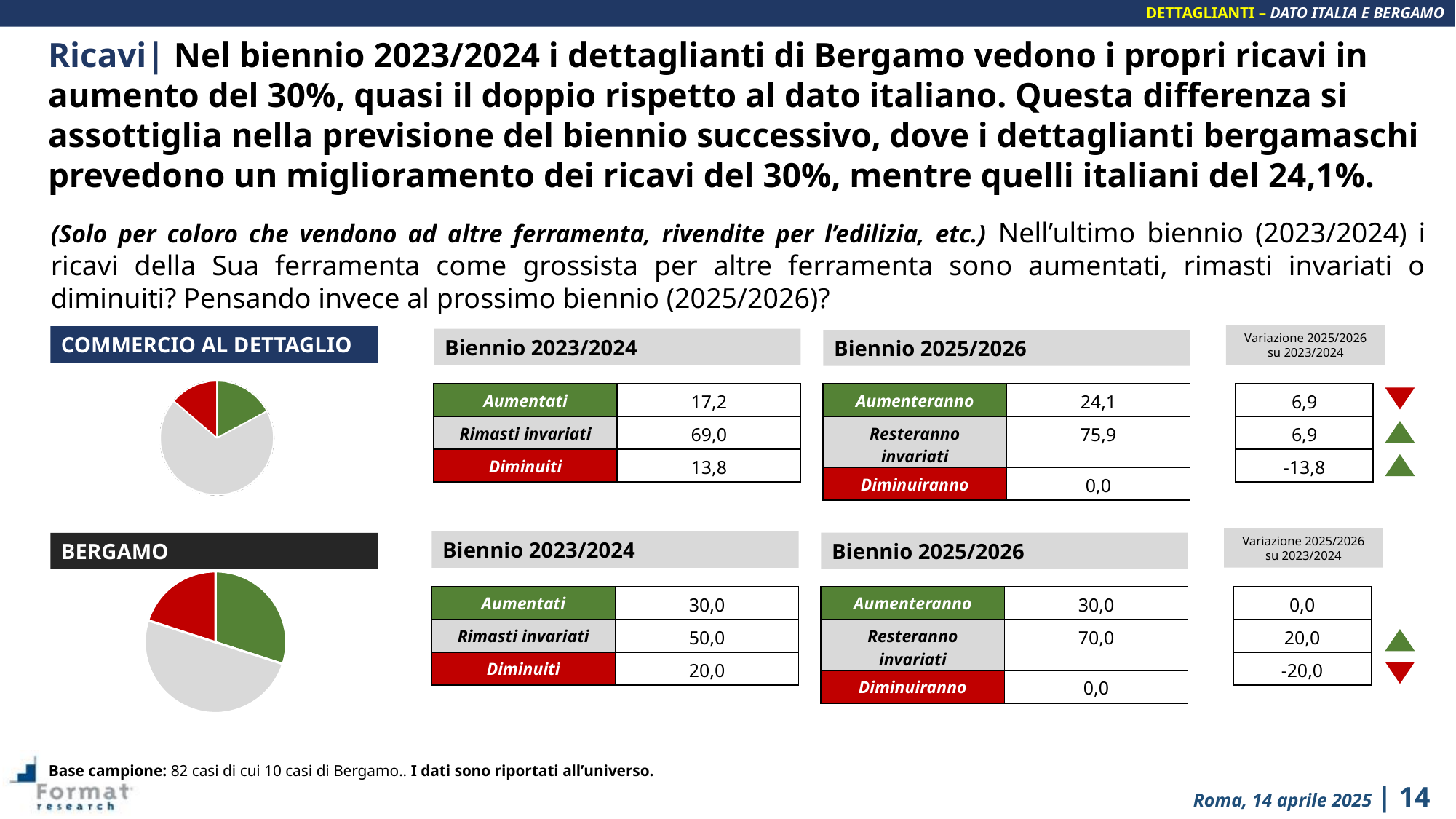
In the COMMERCIO AL DETTAGLIO pie chart, which category has the largest slice? Rimasti invariati In the BERGAMO table for Biennio 2025/2026, what is the value for Resteranno invariati? 70,0 In the BERGAMO table for Biennio 2023/2024, what is the value for Diminuiti? 20,0 What kind of chart is shown next to the COMMERCIO AL DETTAGLIO label? Pie chart What is the difference between the Aumentati values for BERGAMO and COMMERCIO AL DETTAGLIO in Biennio 2023/2024? 12,8 In the BERGAMO pie chart, which category has the smallest slice? Diminuiti What colour represents the Diminuiti category in the pie charts? Red Which is larger in Biennio 2023/2024: the Diminuiti value for BERGAMO or for COMMERCIO AL DETTAGLIO? BERGAMO In the COMMERCIO AL DETTAGLIO table for Biennio 2023/2024, what is the value for Rimasti invariati? 69,0 How many slices does the BERGAMO pie chart have? 3 In the COMMERCIO AL DETTAGLIO table, what is the Variazione 2025/2026 su 2023/2024 for Diminuiranno? -13,8 In the COMMERCIO AL DETTAGLIO table for Biennio 2023/2024, what is the value for Aumentati? 17,2